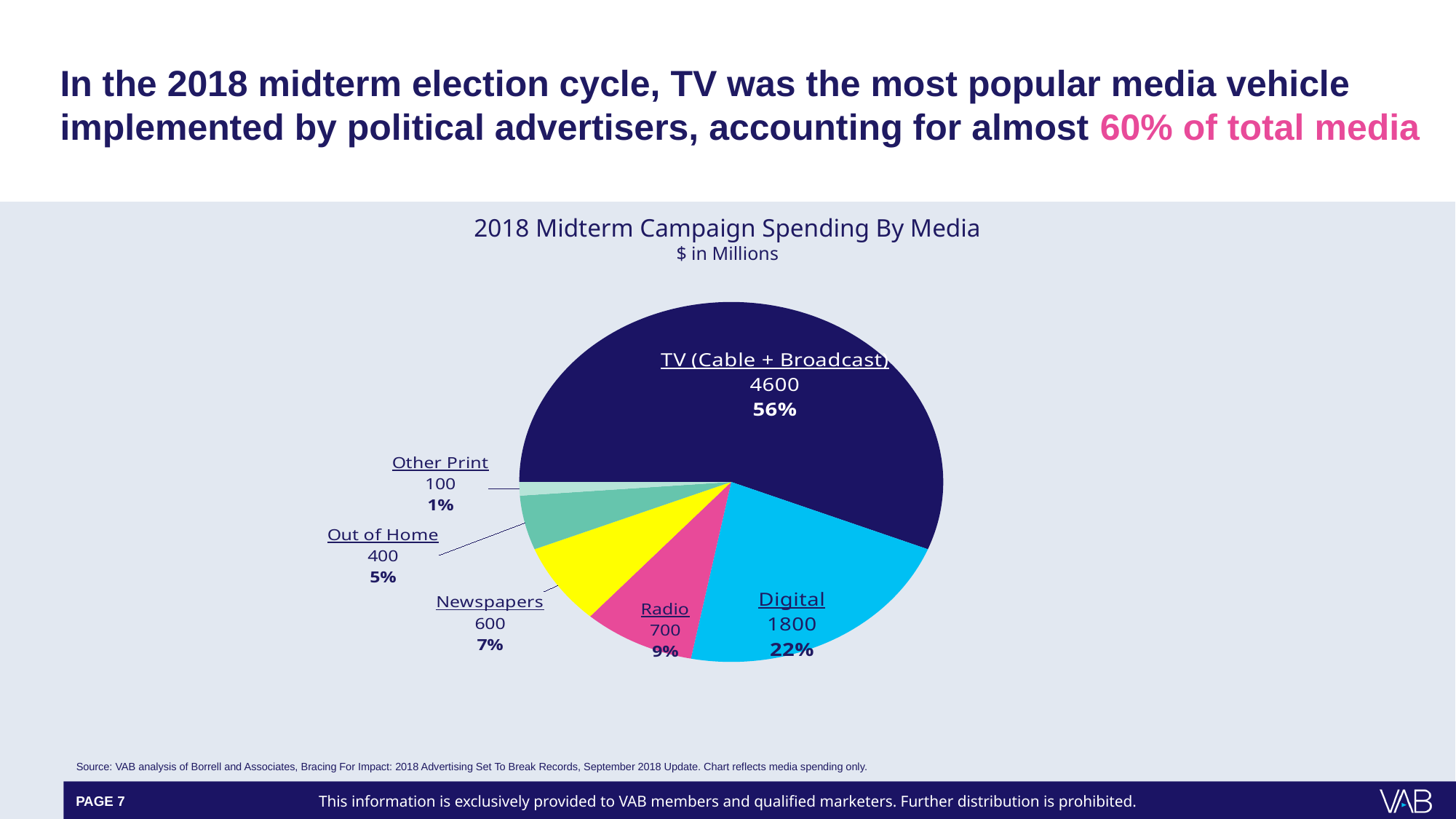
What is the spending value for TV (Cable + Broadcast)? 4600 What type of chart is shown on the slide? pie chart What is the spending value for Radio? 700 What is the spending value for Digital? 1800 What is the difference in spending between TV (Cable + Broadcast) and Digital? 2800 What share of the pie does Newspapers account for? 7% Which media category has the largest slice? TV (Cable + Broadcast) What share of the pie does Out of Home account for? 5% Which has higher spending, Radio or Newspapers? Radio Which media category has the smallest slice? Other Print How many media categories are shown in the pie chart? 6 What is the title of the chart? 2018 Midterm Campaign Spending By Media